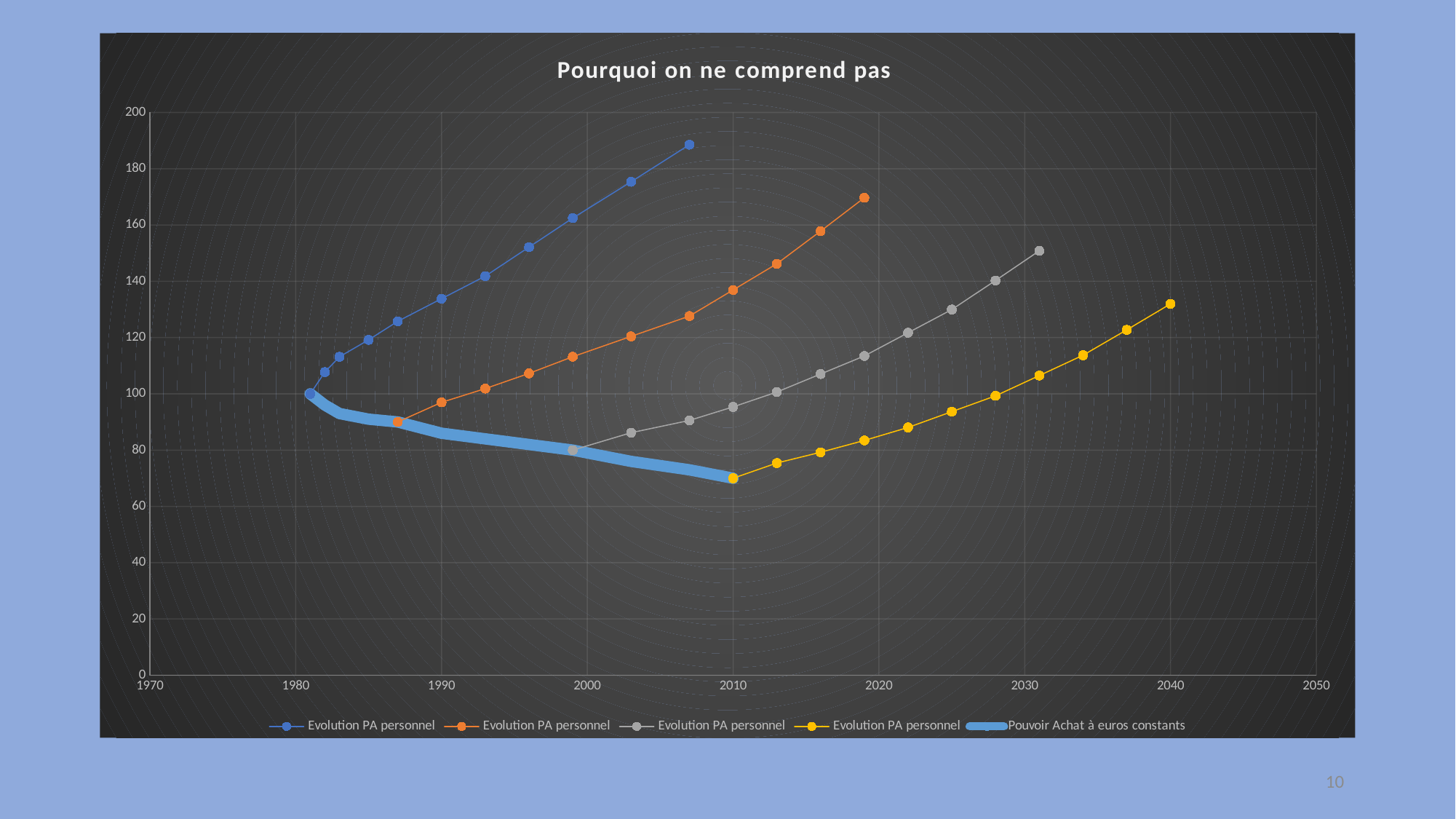
Is the value of the yellow 'Evolution PA personnel' series at 2010 greater or less than 80? less Does the yellow 'Evolution PA personnel' series rise or fall from 2010 to 2040? rise Does the thick 'Pouvoir Achat à euros constants' line rise or fall from 1980 to 2010? fall What is the legend label of the thick light-blue line? Pouvoir Achat à euros constants Is the last point of the orange 'Evolution PA personnel' series (around 2019) greater or less than 160? greater What type of chart is shown on the slide? line chart How many series does the legend list? 5 Which series reaches the highest value on the chart? the dark-blue Evolution PA personnel series At 2010, which is higher: the orange 'Evolution PA personnel' series or the grey 'Evolution PA personnel' series? the orange series What is the title of the chart? Pourquoi on ne comprend pas Is the value of the yellow 'Evolution PA personnel' series at 2040 greater or less than 120? greater